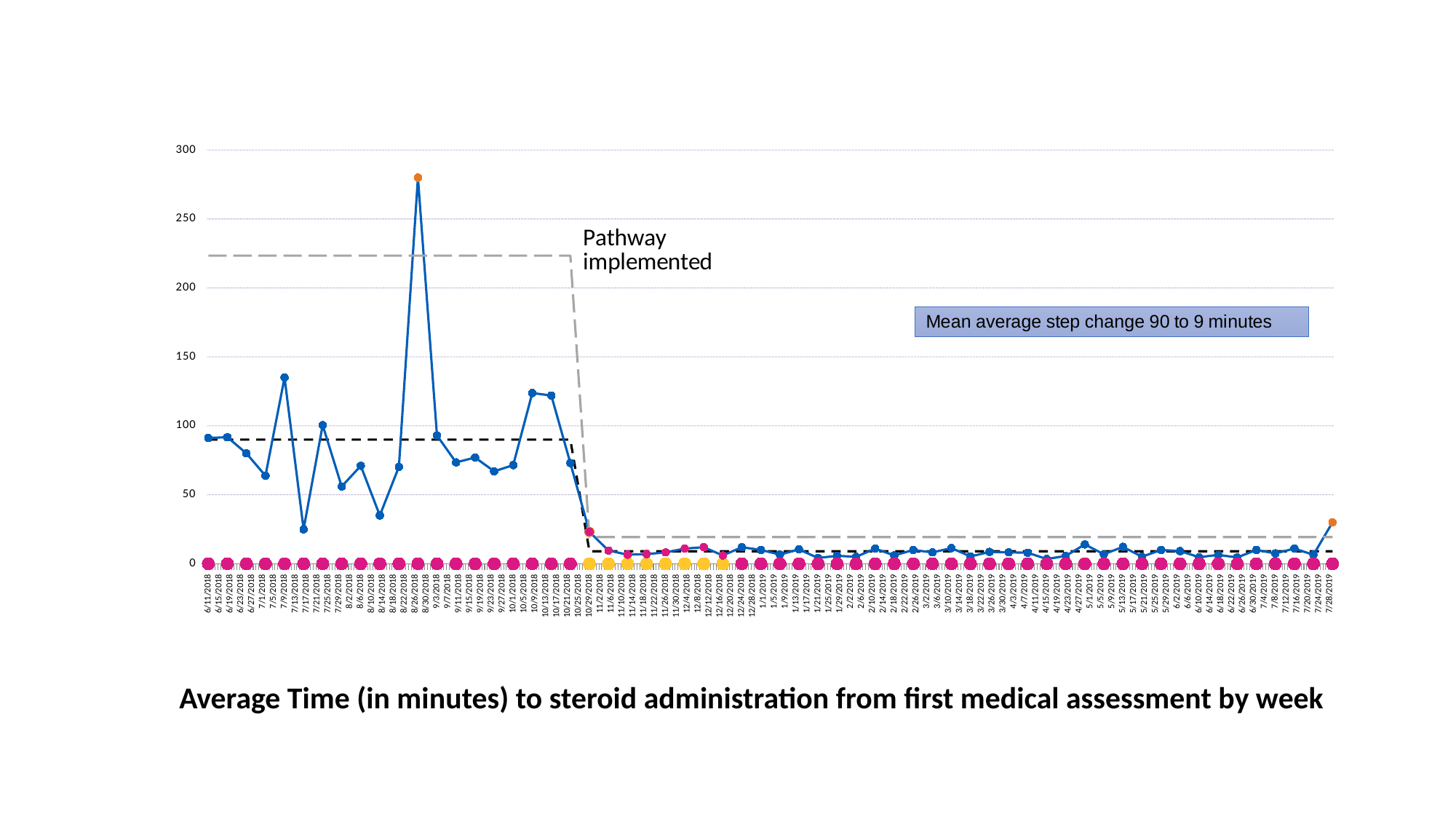
Is the value for 6/11/2018 greater or less than 100? less Is the value for 8/26/2018 greater or less than 250? greater Are the values after the 'Pathway implemented' marker higher or lower than the values before it? lower Is the value for 7/28/2019 greater or less than 100? less Which week has the highest value on the chart? 8/26/2018 Overall, do the values rise or fall from the left of the x axis to the right? fall Which is larger, the value for 8/26/2018 or the value for 7/28/2019? 8/26/2018 What kind of chart is shown on the slide? line chart What does the text box on the right of the chart say? Mean average step change 90 to 9 minutes What is the title of the chart? Average Time (in minutes) to steroid administration from first medical assessment by week